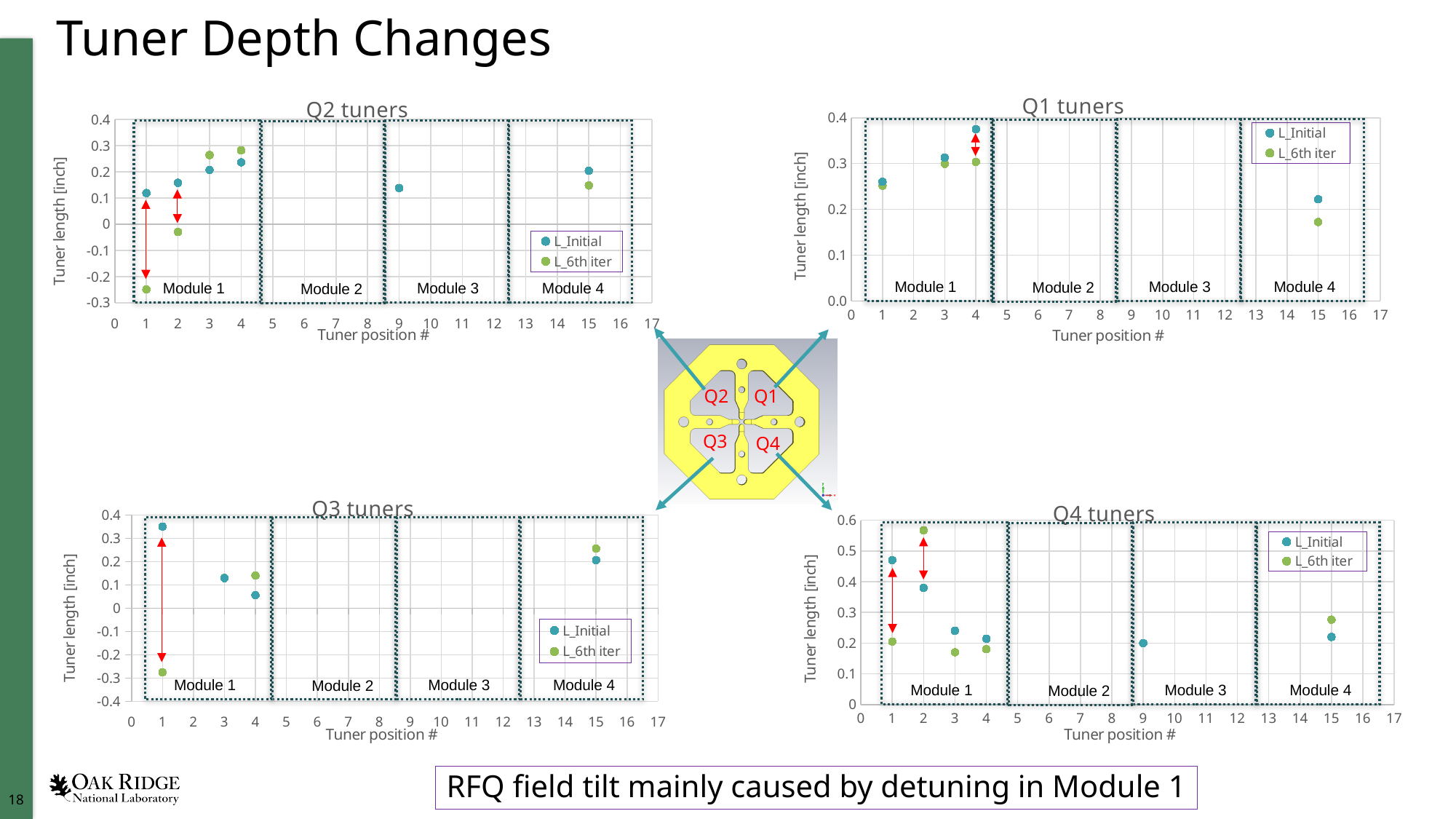
In the Q1 tuners chart, at which tuner position is the L_Initial value highest? 4 In the Q4 tuners chart, how many L_Initial points are plotted? 6 In the Q3 tuners chart, which is larger for L_Initial: the value at tuner position 1 or at tuner position 15? tuner position 1 In the Q2 tuners chart, at which tuner position is the L_6th iter value lowest? 1 What is the y-axis title of the Q3 tuners chart? Tuner length [inch] How many series does the legend of the Q1 tuners chart list? 2 In the Q4 tuners chart, is the L_Initial value at tuner position 1 greater or less than 0.4? greater In the Q4 tuners chart, at which tuner position is the L_6th iter value highest? 2 In the Q3 tuners chart, is the L_6th iter value at tuner position 1 greater or less than -0.2? less What kind of chart is the Q2 tuners chart? scatter chart In the Q1 tuners chart, is the L_Initial value at tuner position 4 greater or less than 0.3? greater